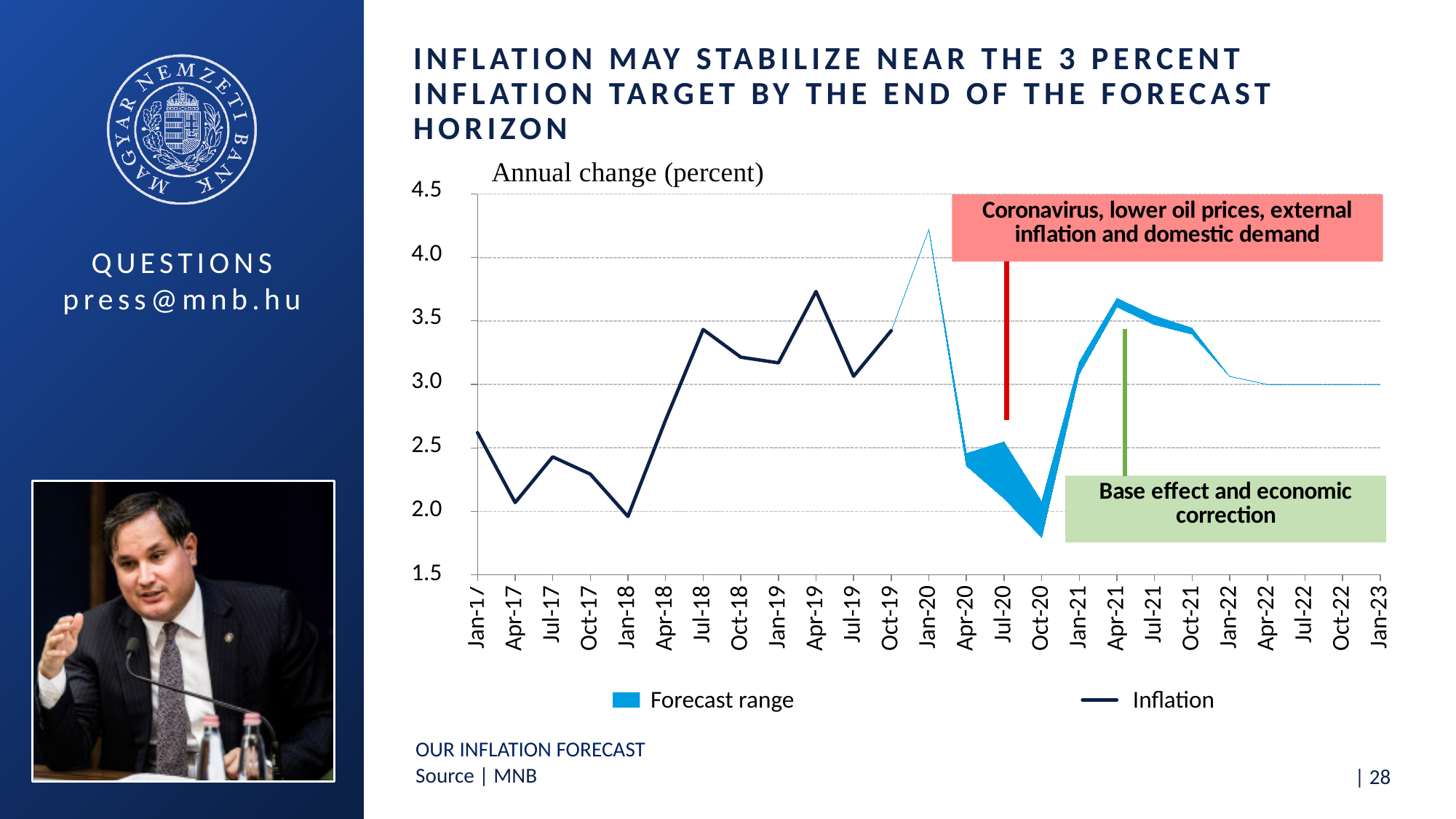
Is the value for Apr-17 greater or less than 2.5? less Is the lowest point of the forecast range around Oct-20 greater or less than 2.0? less Is the inflation value for Jul-18 greater or less than 3.0? greater Which is larger, the inflation value for Apr-19 or for Jul-19? Apr-19 What is the label above the y axis of the chart? Annual change (percent) What kind of chart is shown on the slide? line chart Does the forecast line rise or fall between Jan-20 and Oct-20? fall How many series does the chart legend list? 2 Does the inflation line rise or fall between Jan-18 and Jul-18? rise What are the two entries in the chart legend? Forecast range and Inflation